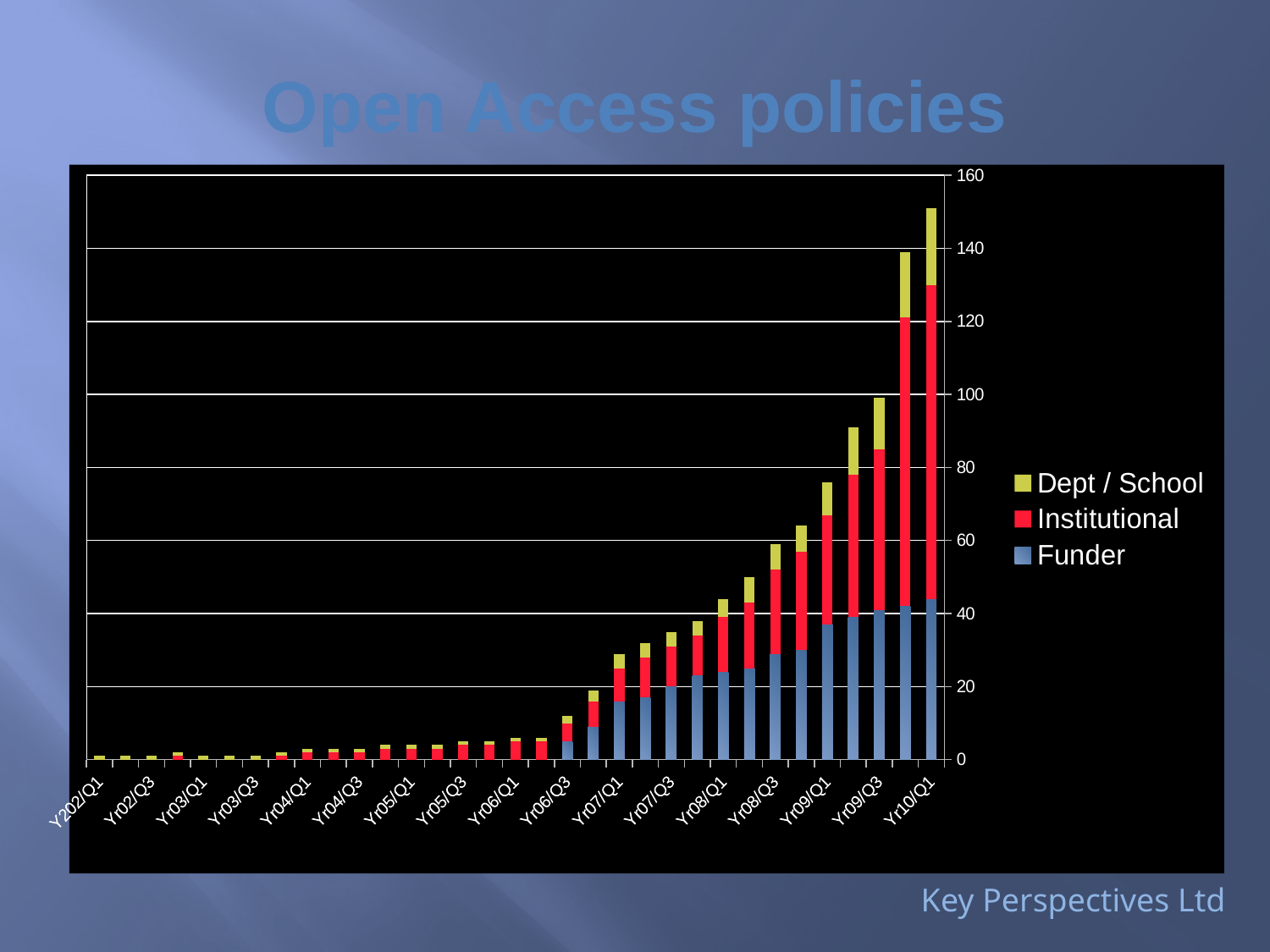
How many series does the legend list? 3 Which series is shown in red in the legend? Institutional Is the total stacked value for Yr08/Q1 greater or less than 40? greater Do the stacked bar totals generally rise or fall from Yr02/Q1 to Yr10/Q1? Rise Is the Funder value for Yr10/Q1 greater or less than 40? greater Which has the larger total stacked value, Yr09/Q3 or Yr10/Q1? Yr10/Q1 Is the total stacked value for Yr09/Q1 greater or less than 80? less What kind of chart is shown on the slide? Stacked bar chart What is the title of the slide containing the chart? Open Access policies Which category has the tallest stacked bar? Yr10/Q1